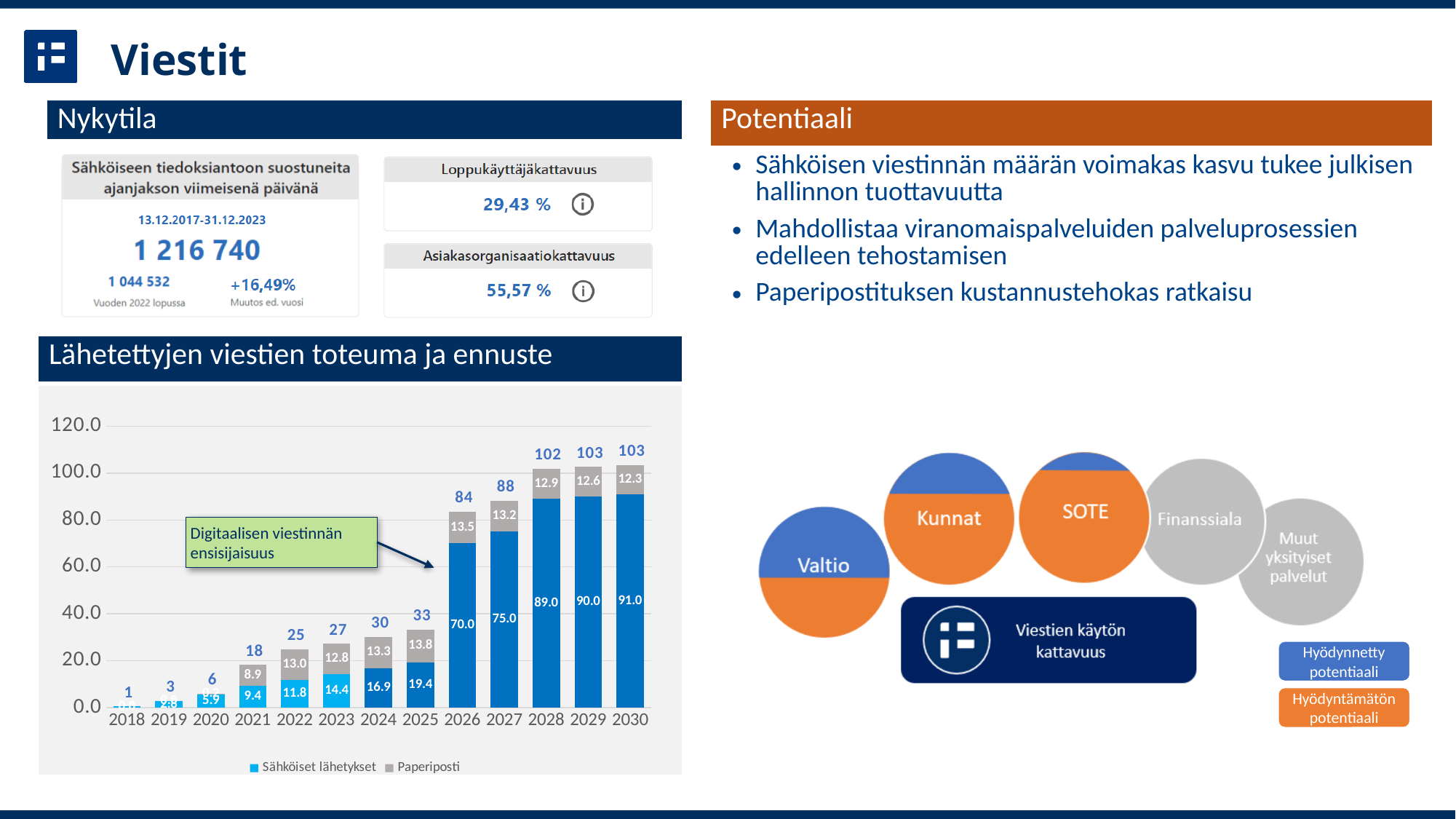
In the chart 'Lähetettyjen viestien toteuma ja ennuste', what is the total of the stacked bar for 2028? 102 How many years are shown on the x axis of the chart 'Lähetettyjen viestien toteuma ja ennuste'? 13 In the chart 'Lähetettyjen viestien toteuma ja ennuste', what is the value of Sähköiset lähetykset for 2026? 70.0 What kind of chart is 'Lähetettyjen viestien toteuma ja ennuste'? Stacked bar chart In the chart 'Lähetettyjen viestien toteuma ja ennuste', which year has the highest value for Sähköiset lähetykset? 2030 In the chart 'Lähetettyjen viestien toteuma ja ennuste', is the value for Sähköiset lähetykset in 2028 greater or less than 80? greater In the chart 'Lähetettyjen viestien toteuma ja ennuste', do the bar totals rise or fall from 2018 to 2030? Rise In the chart 'Lähetettyjen viestien toteuma ja ennuste', what is the difference between the Sähköiset lähetykset values for 2027 and 2026? 5.0 In the chart 'Lähetettyjen viestien toteuma ja ennuste', which is larger for 2023: Sähköiset lähetykset or Paperiposti? Sähköiset lähetykset In the chart 'Lähetettyjen viestien toteuma ja ennuste', which year has the lowest total? 2018 In the chart 'Lähetettyjen viestien toteuma ja ennuste', what is the value of Paperiposti for 2025? 13.8 How many series does the legend of the chart 'Lähetettyjen viestien toteuma ja ennuste' list? 2